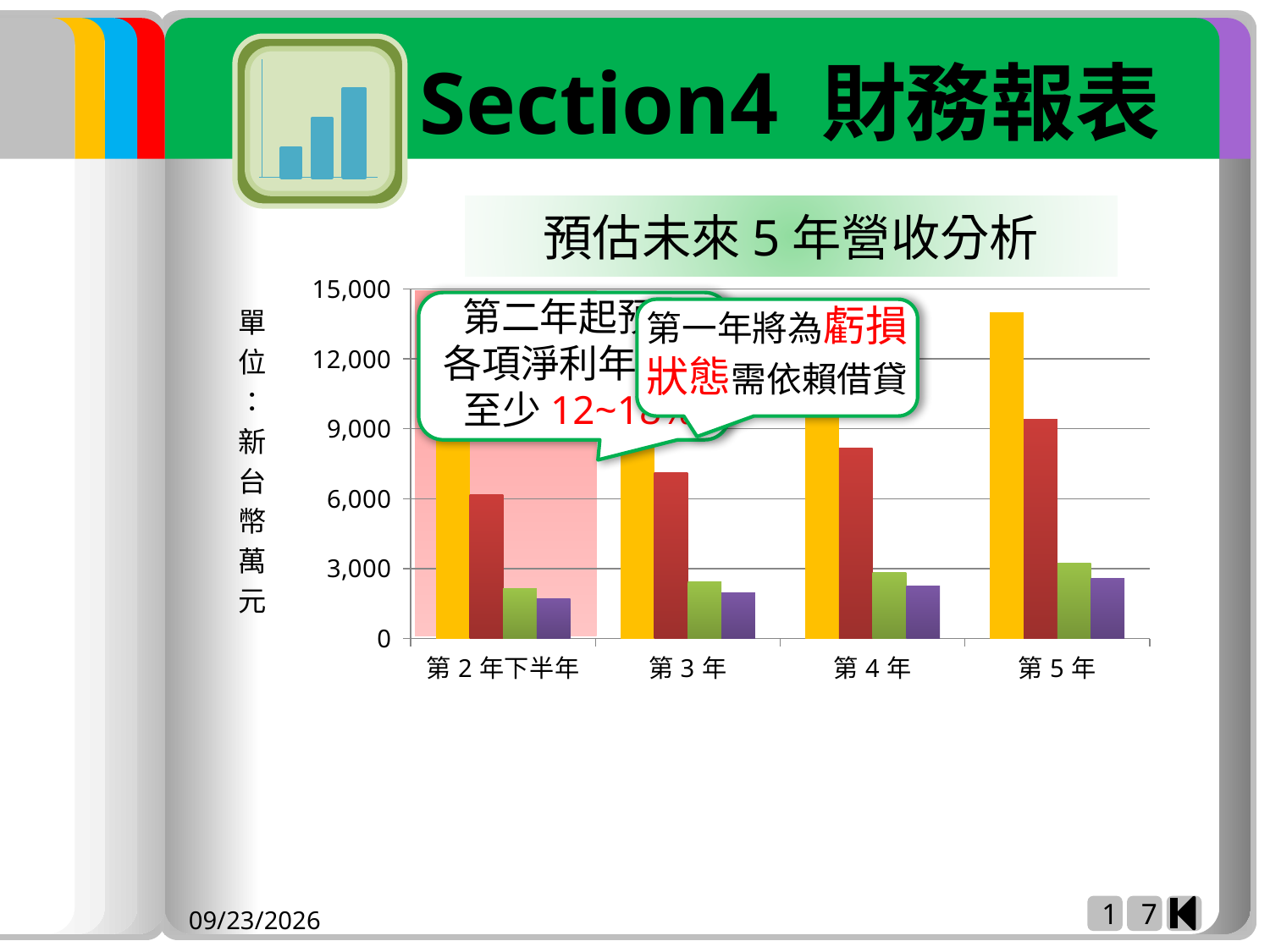
Which is larger, the red bar for 第 3 年 or the red bar for 第 5 年? 第 5 年 Is the value of the red bar for 第 5 年 greater or less than 6,000? greater How many bars are plotted for each category in the chart? 4 What unit is stated for the values in the chart? 新台幣萬元 Is the value of the purple bar for 第 5 年 greater or less than 3,000? less What is the title of the chart? 預估未來 5 年營收分析 Do the yellow bars rise or fall from 第 2 年下半年 to 第 5 年? rise What kind of chart is shown on the slide? bar chart Is the value of the yellow bar for 第 5 年 greater or less than 12,000? greater In which category is the yellow bar the highest? 第 5 年 How many categories are shown on the x axis of the chart? 4